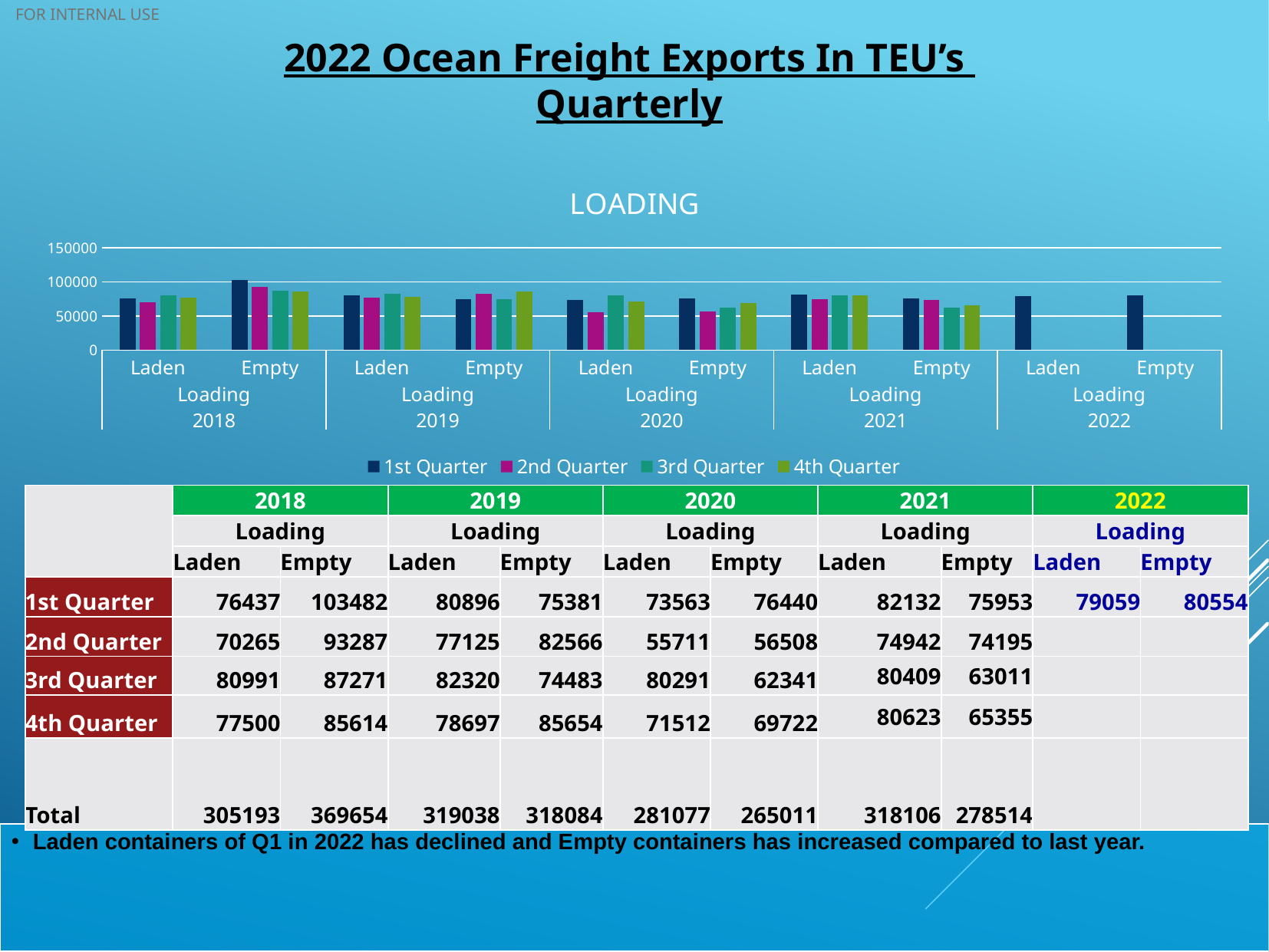
What is the title of the chart? LOADING Is the 1st Quarter value for Empty in 2018 greater or less than 100000? greater How many years are shown along the x axis of the chart? 5 What kind of chart is shown on the slide? bar chart Which is larger in 2018: the 1st Quarter value for Laden or for Empty? Empty Which bar in the chart is the highest? 1st Quarter, Empty, 2018 How many series does the chart legend list? 4 What is the 3rd Quarter value for Laden in 2021? 80409 What is the total of the four quarters for Laden in 2018? 305193 What is the 1st Quarter value for Empty in 2018? 103482 What is the difference between the 1st Quarter Empty and Laden values in 2022? 1495 What is the 1st Quarter value for Laden in 2022? 79059